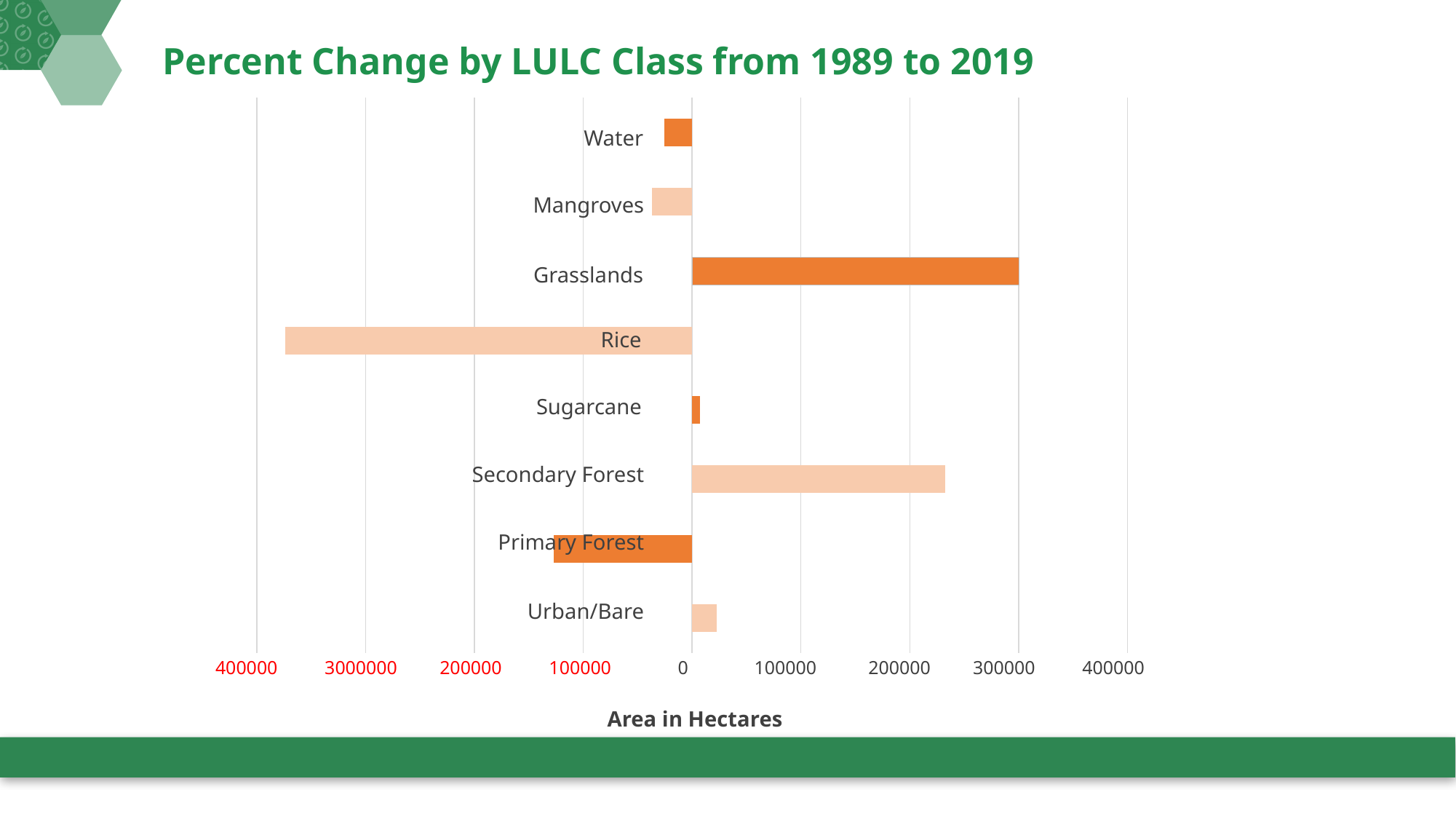
What is the label on the horizontal axis? Area in Hectares Which is larger, the value for Grasslands or the value for Secondary Forest? Grasslands How many LULC classes are plotted on the chart? 8 What is the title of the chart? Percent Change by LULC Class from 1989 to 2019 How many LULC classes show a negative change (bars extending to the left of 0)? 4 Which LULC class has the largest positive change? Grasslands Is the value for Secondary Forest greater or less than 200000? greater What kind of chart is shown on the slide? bar chart Which is larger, the value for Urban/Bare or the value for Sugarcane? Urban/Bare Is the value for Primary Forest greater or less than 0? less Which LULC class has the largest negative change (the bar extending furthest to the left)? Rice Is the value for Urban/Bare greater or less than 100000? less